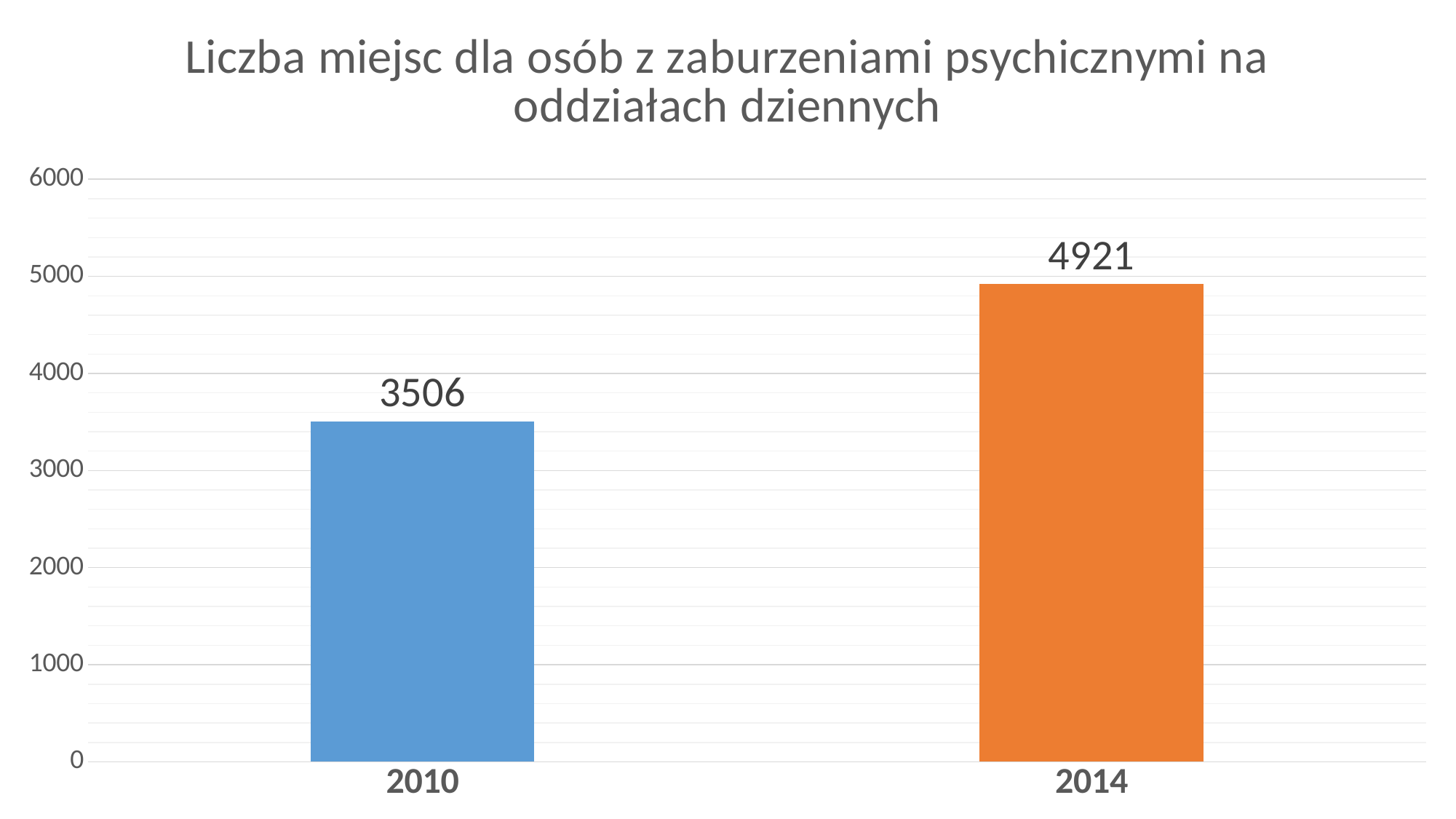
What is the value for 2014? 4921 What is the difference between the values for 2014 and 2010? 1415 Do the values rise or fall from 2010 to 2014? rise Is the value for 2010 greater or less than 4000? less What is the value for 2010? 3506 How many categories are shown on the x axis? 2 What is the title of the chart? Liczba miejsc dla osób z zaburzeniami psychicznymi na oddziałach dziennych Which year has the lowest value? 2010 Which year has the highest value? 2014 Is the value for 2014 greater or less than 4000? greater Which is larger, the value for 2010 or the value for 2014? 2014 What kind of chart is this? bar chart